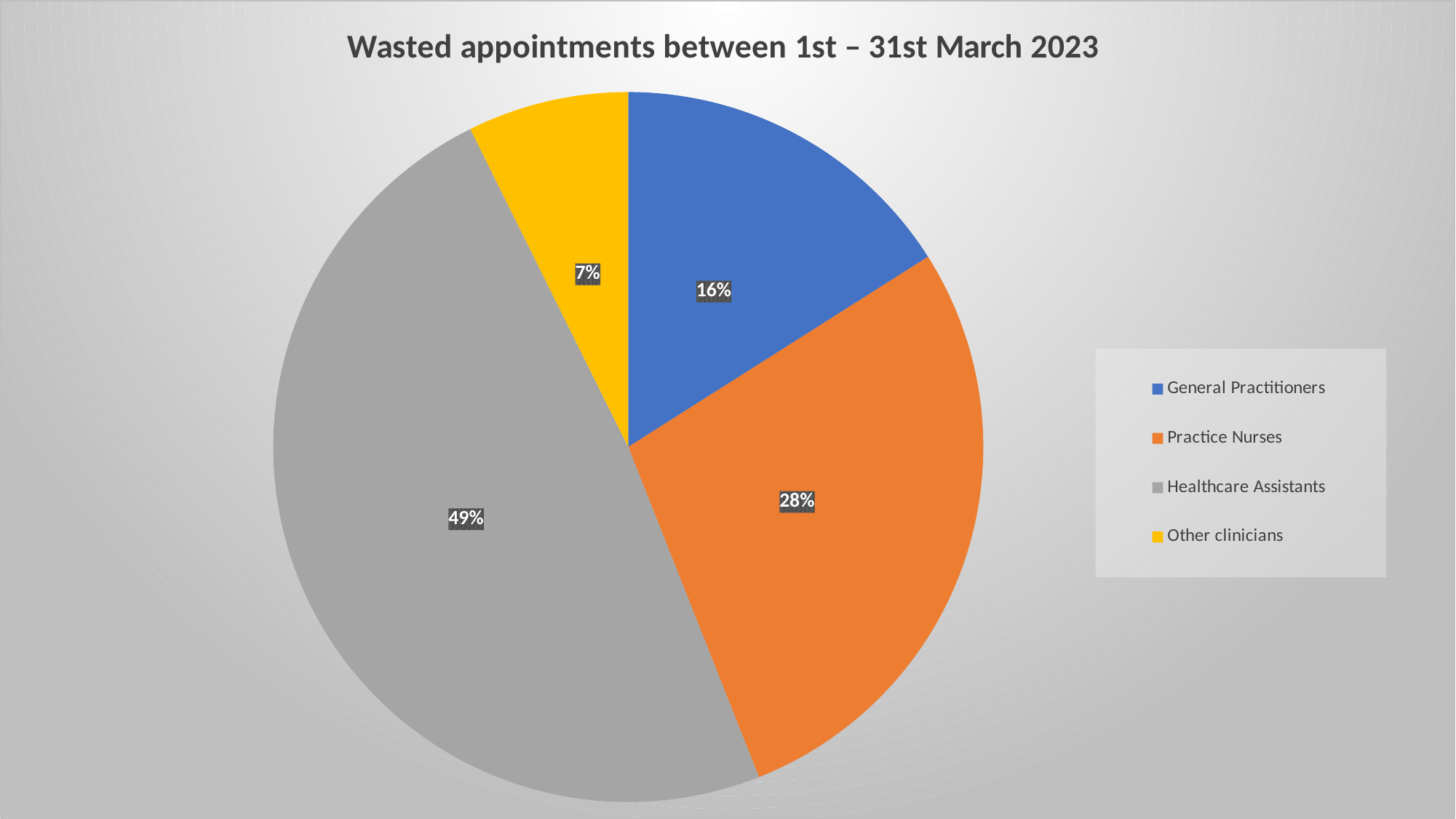
What share of wasted appointments is attributed to Other clinicians? 7% What share of wasted appointments is attributed to Practice Nurses? 28% Which has a larger share of wasted appointments, General Practitioners or Practice Nurses? Practice Nurses What is the difference in percentage points between the Healthcare Assistants share and the Practice Nurses share? 21 What share of wasted appointments is attributed to Healthcare Assistants? 49% What type of chart is shown on the slide? Pie chart What is the title of the chart? Wasted appointments between 1st – 31st March 2023 How many categories are shown in the pie chart? 4 Which category accounts for the largest share of wasted appointments? Healthcare Assistants Which colour represents Other clinicians in the chart? Yellow Which category accounts for the smallest share of wasted appointments? Other clinicians